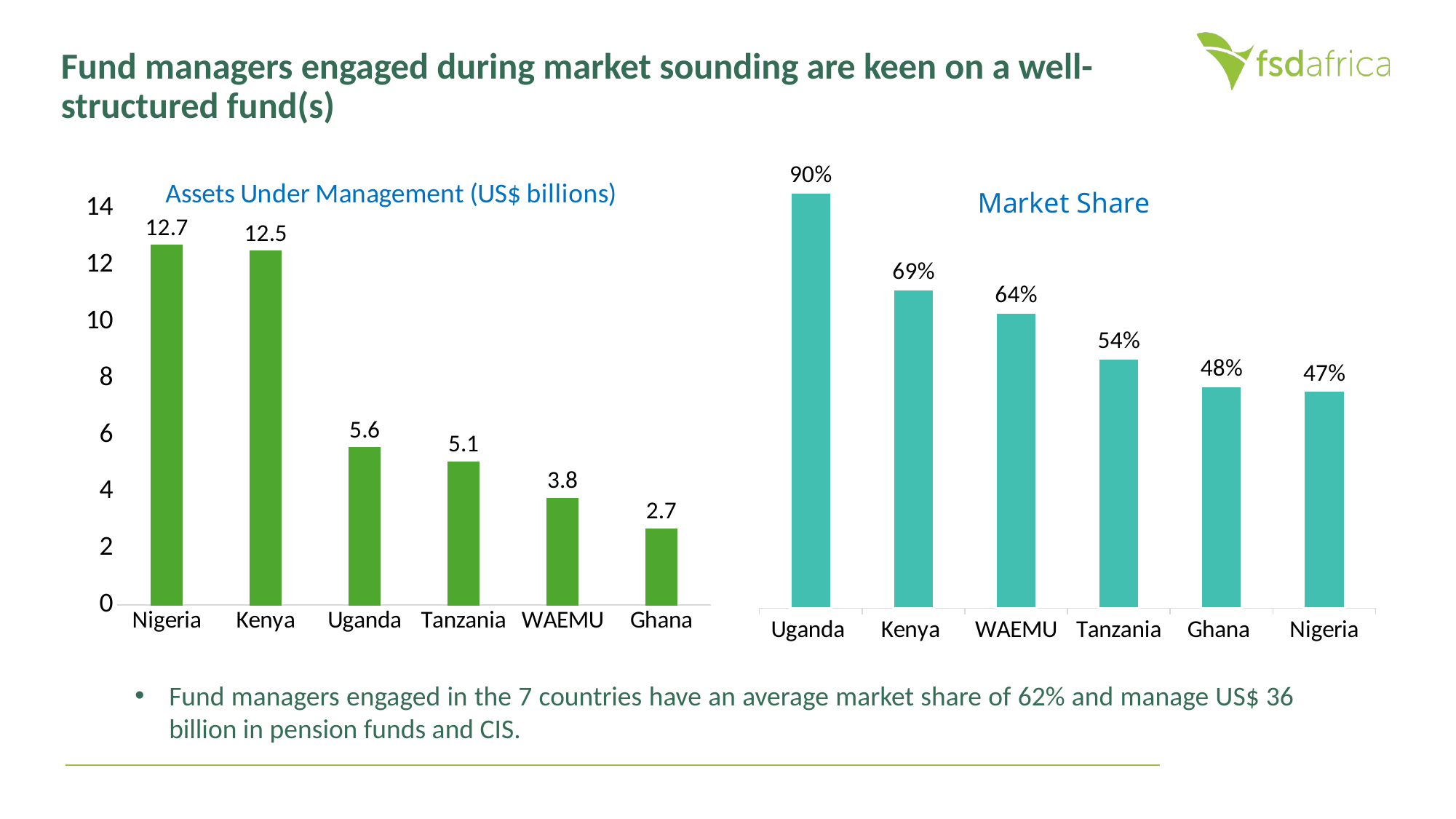
In the Assets Under Management (US$ billions) chart, what is the value for WAEMU? 3.8 In the Assets Under Management (US$ billions) chart, do the values rise or fall from left to right? fall In the Market Share chart, which country has the highest market share? Uganda What type of chart is the Market Share chart? bar chart In the Market Share chart, what is the value for Uganda? 90% In the Market Share chart, what is the difference between Kenya and WAEMU? 5% In the Assets Under Management (US$ billions) chart, how many categories are shown? 6 In the Assets Under Management (US$ billions) chart, what is the value for Nigeria? 12.7 In the Assets Under Management (US$ billions) chart, what is the difference between Nigeria and Kenya? 0.2 In the Market Share chart, what is the value for Tanzania? 54% In the Assets Under Management (US$ billions) chart, which country has the lowest value? Ghana In the Market Share chart, which is larger, the value for Ghana or the value for Nigeria? Ghana